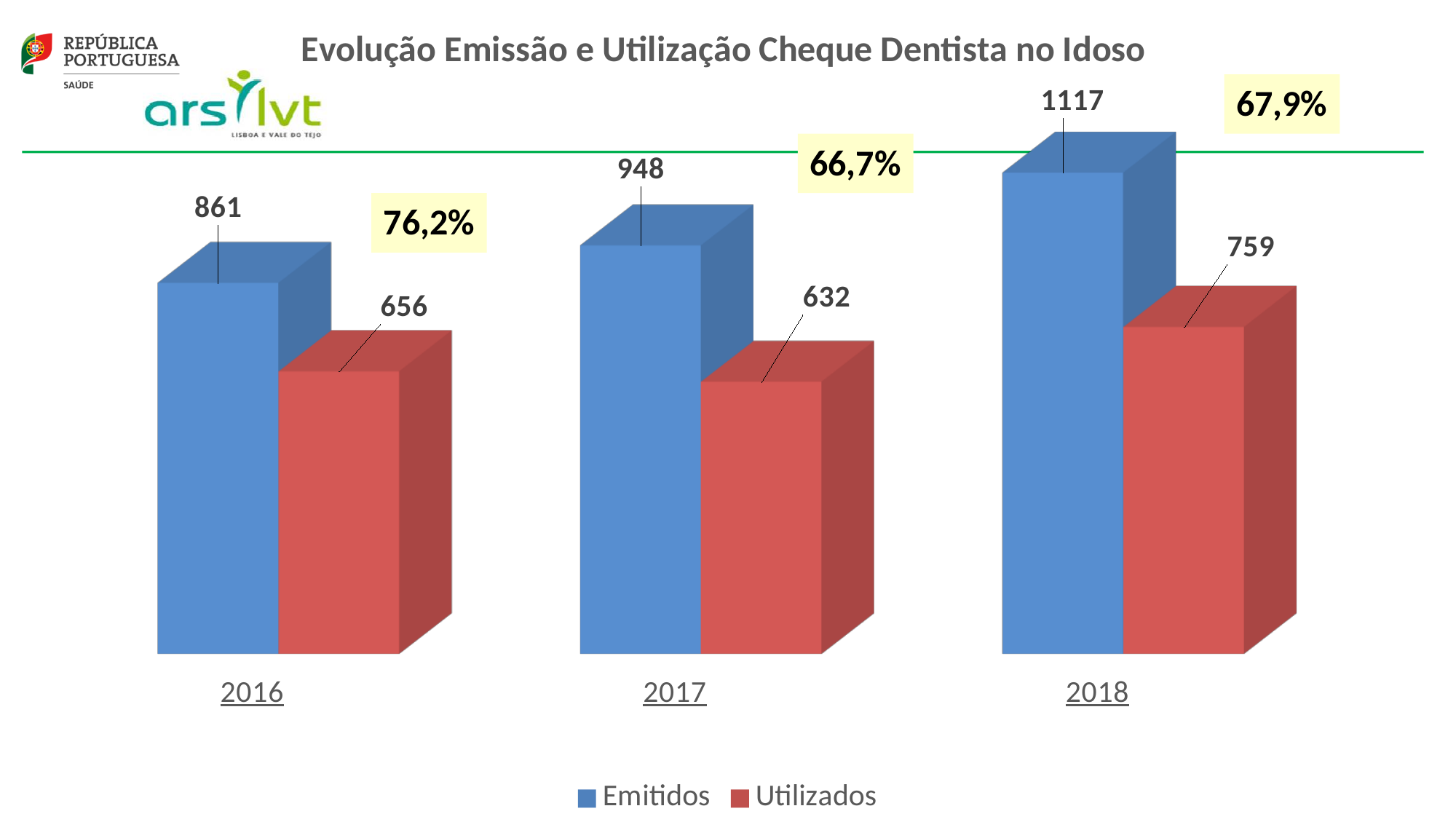
What is the value of Emitidos in 2016? 861 Do the Emitidos values rise or fall from 2016 to 2018? Rise What is the difference between Emitidos in 2017 and Emitidos in 2016? 87 What kind of chart is shown on the slide? Bar chart How many years are shown on the x axis? 3 Which is larger, Utilizados in 2016 or Utilizados in 2017? Utilizados in 2016 Which year has the lowest value for Utilizados? 2017 What is the difference between Emitidos and Utilizados in 2018? 358 What is the value of Utilizados in 2017? 632 What is the value of Utilizados in 2018? 759 How many series does the legend list? 2 Which year has the highest value for Emitidos? 2018